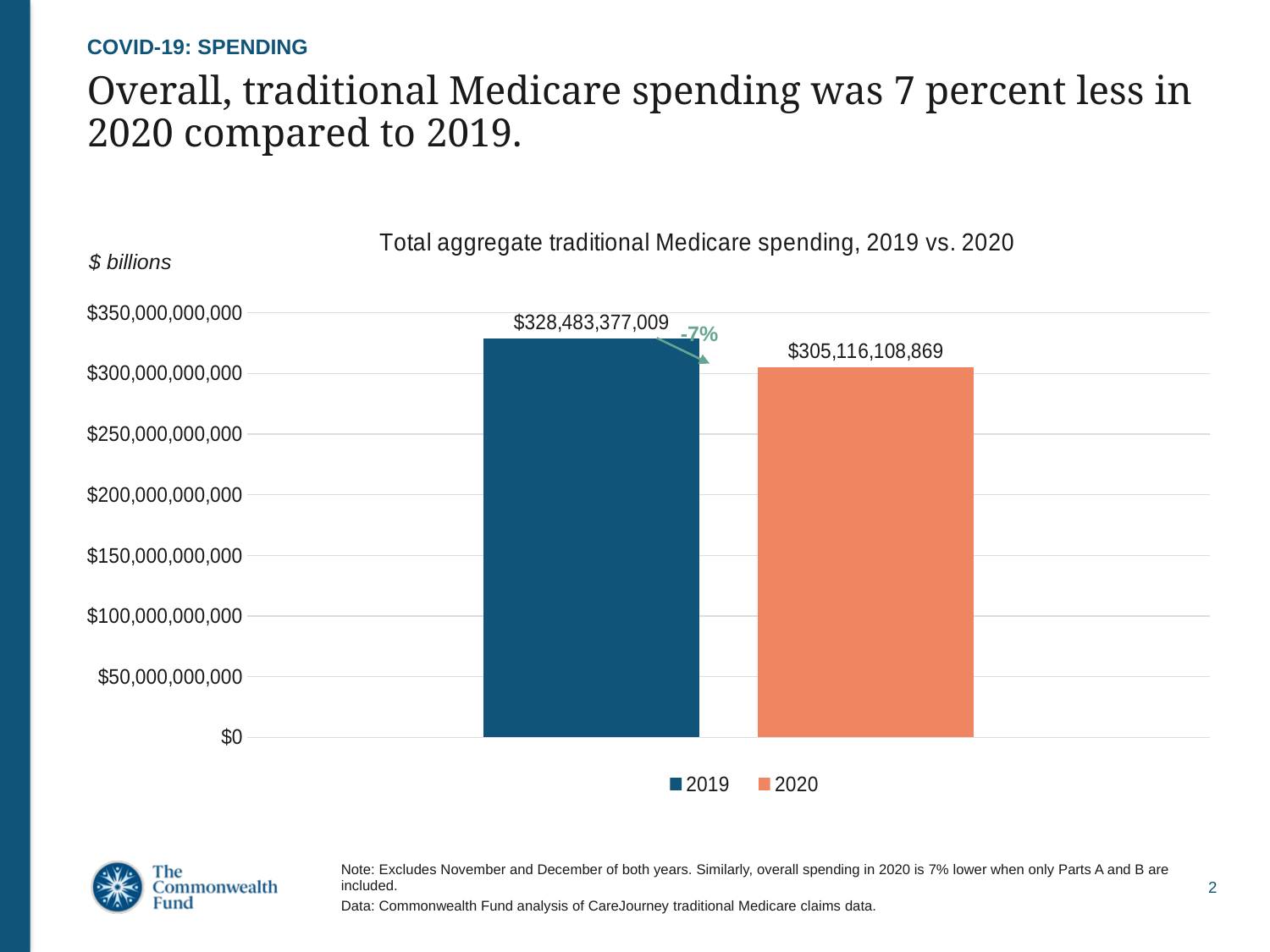
Is the value for 2019 greater or less than $350,000,000,000? less Which year has the lower spending? 2020 How many bars are plotted in the chart? 2 How many series does the legend list? 2 Which year has the higher spending? 2019 What percentage change is annotated between the 2019 and 2020 bars? -7% What is the difference between the 2019 and 2020 values? $23,367,268,140 What is the value for 2020? $305,116,108,869 Is the value for 2020 greater or less than $300,000,000,000? greater Is the value for 2019 larger or smaller than the value for 2020? larger What is the value for 2019? $328,483,377,009 What kind of chart is shown? bar chart